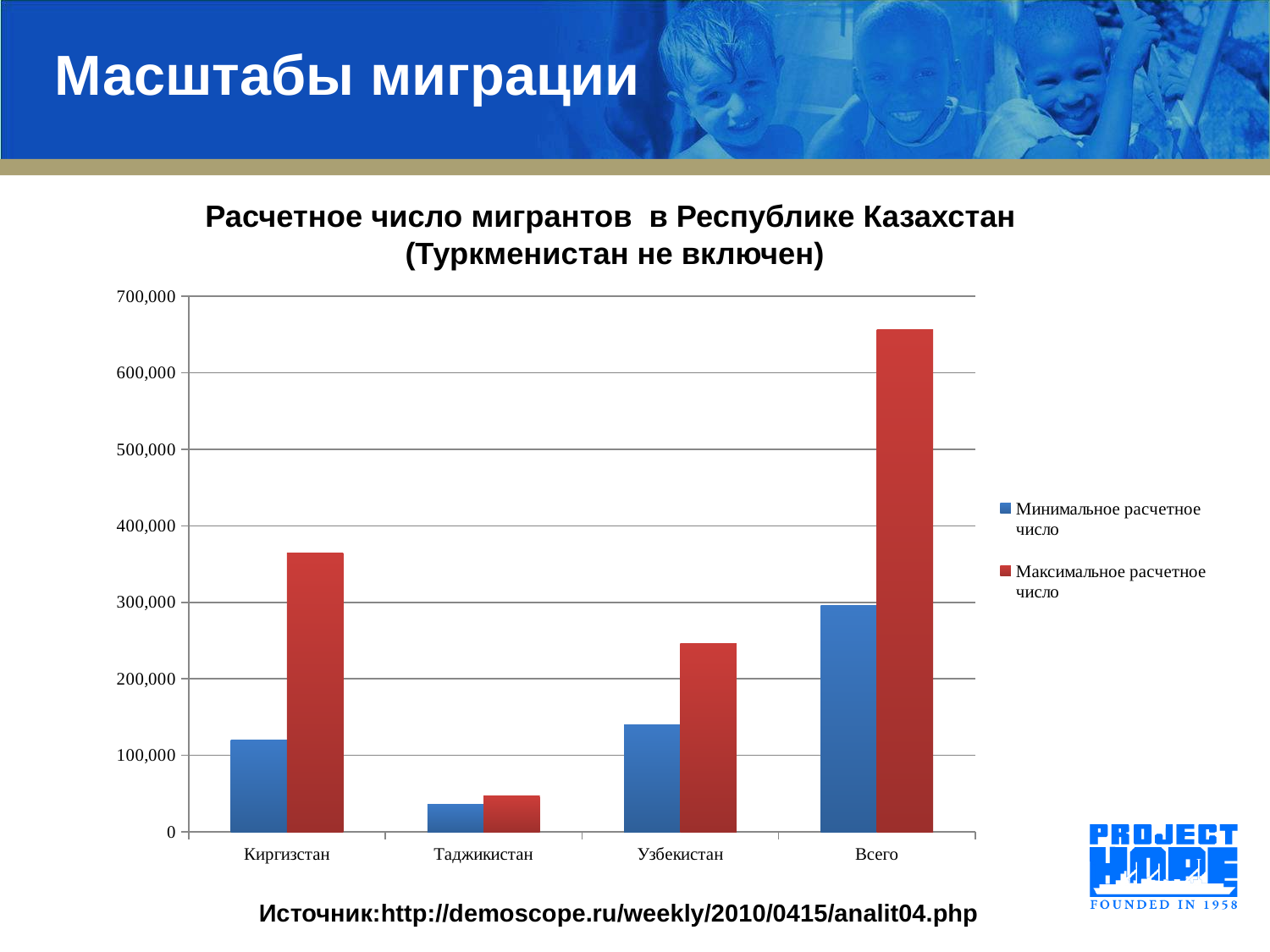
What kind of chart is shown on the slide? bar chart What colour are the bars for Максимальное расчетное число? red Which category has the lowest value for Минимальное расчетное число? Таджикистан What is the title of the chart? Расчетное число мигрантов в Республике Казахстан (Туркменистан не включен) Which is larger: the Максимальное расчетное число for Киргизстан or for Узбекистан? Киргизстан Is the Максимальное расчетное число for Киргизстан greater or less than 300,000? greater Is the Максимальное расчетное число for Всего greater or less than 600,000? greater How many categories are shown on the x axis of the chart? 4 Which category has the highest value for Максимальное расчетное число? Всего Is the Минимальное расчетное число for Таджикистан greater or less than 100,000? less How many series does the chart's legend list? 2